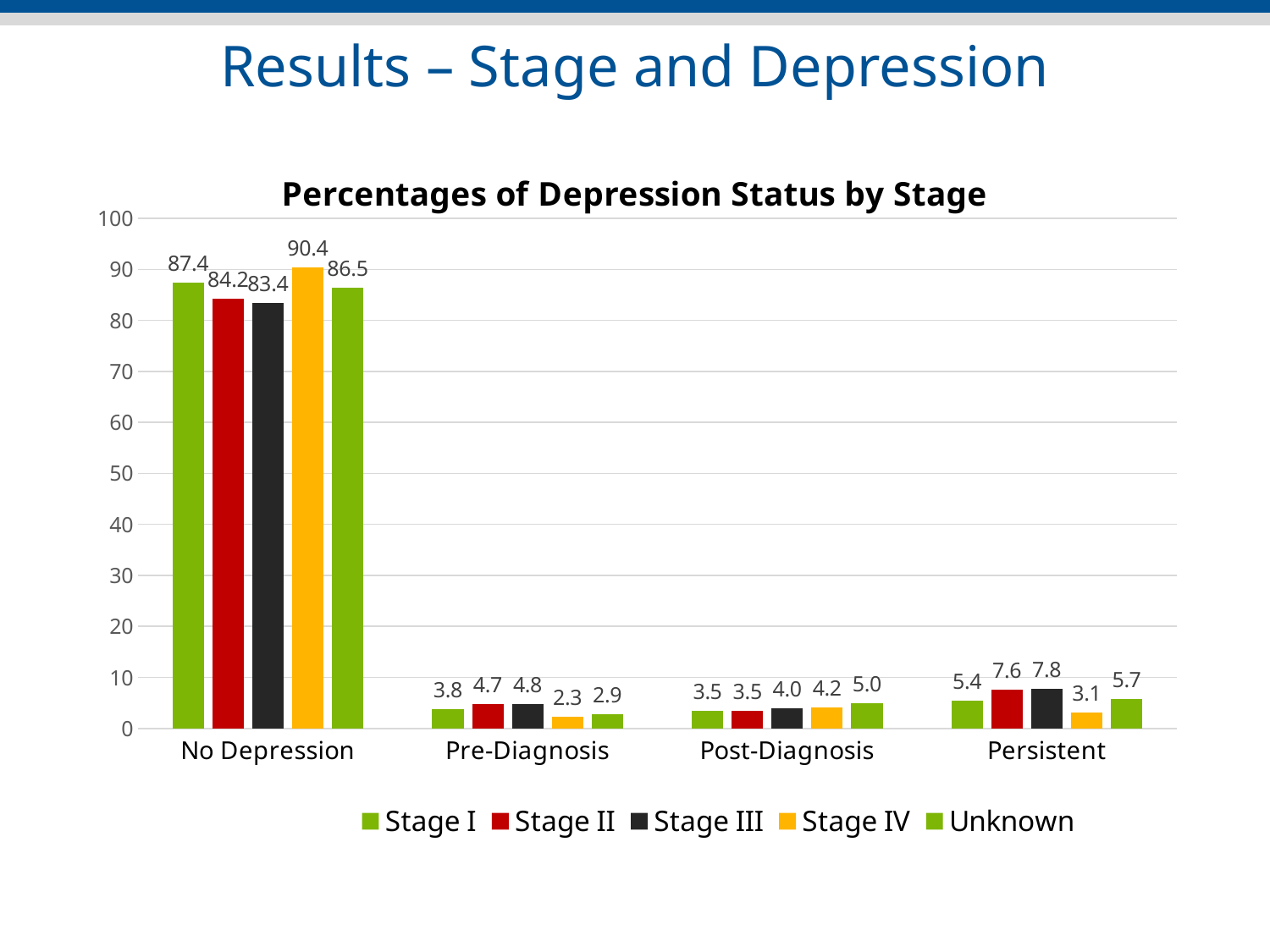
Which stage has the highest value in the No Depression category? Stage IV In the Post-Diagnosis category, which is larger: the value for Unknown or the value for Stage I? Unknown What is the value for Stage III in the Persistent category? 7.8 How many depression status categories are shown on the x axis? 4 What is the title of the chart? Percentages of Depression Status by Stage What is the value for Stage II in the Pre-Diagnosis category? 4.7 What is the value for Stage IV in the No Depression category? 90.4 Is the value for Stage I in the No Depression category greater or less than 80? greater How many series does the legend list? 5 What is the difference between the Stage IV and Stage III values in the No Depression category? 7.0 Which stage has the lowest value in the Persistent category? Stage IV What type of chart is shown on the slide? Bar chart